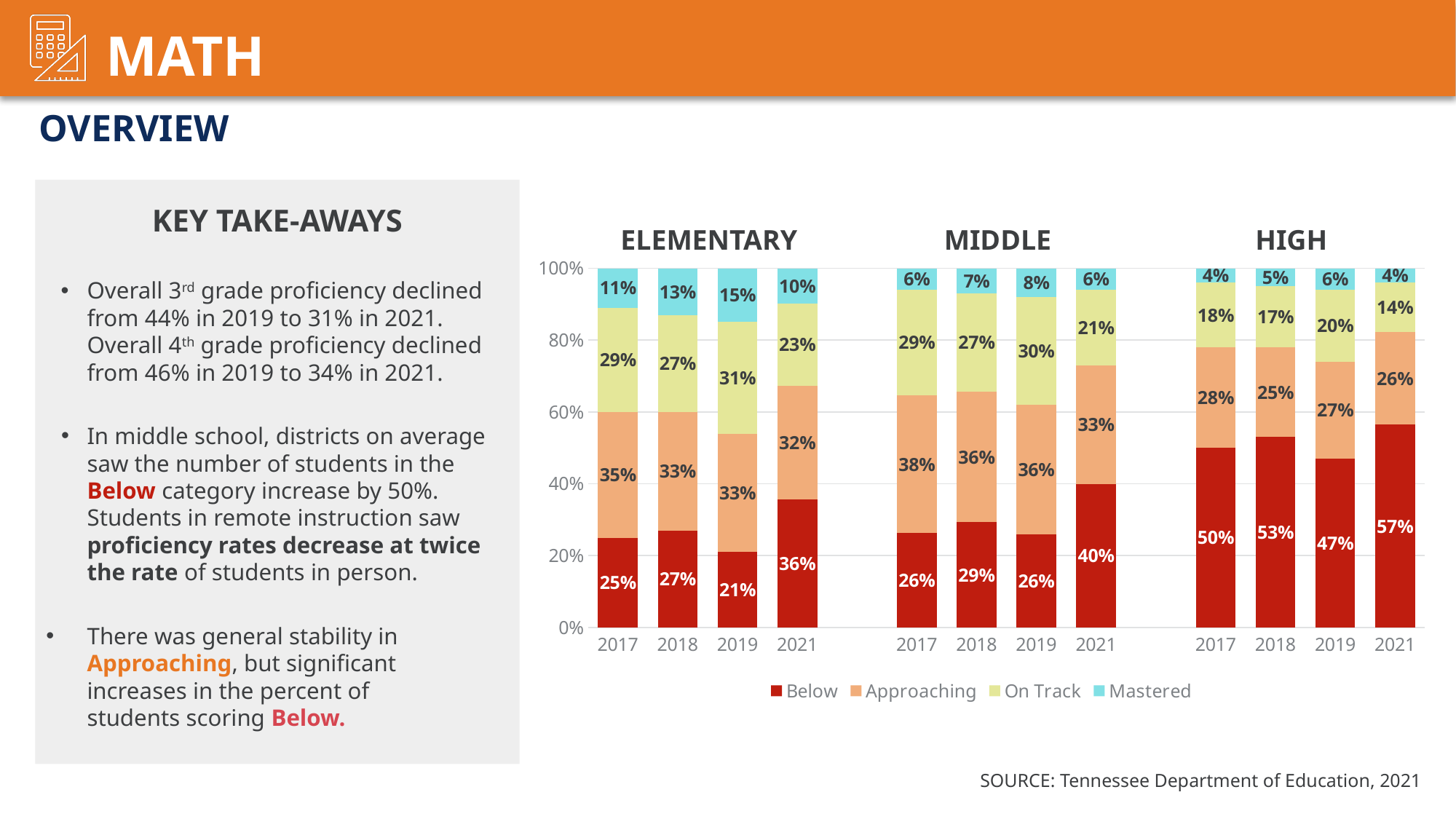
In the Elementary group, which year has the lowest Below percentage? 2019 How many series does the legend list? 4 By how many percentage points did the Elementary Below share change from 2019 to 2021? 15% Does the Mastered share for High school rise or fall from 2019 to 2021? Fall Which is larger in 2021: the Below share for Middle or the Below share for Elementary? Middle How many years are shown for each school level group? 4 In the High group, which year has the highest Below percentage? 2021 What is the combined share of Below and Approaching for High school in 2021? 83% What percentage of Middle school students were Mastered in 2019? 8% What kind of chart is shown on the slide? Stacked bar chart What percentage of Elementary students scored Below in 2021? 36% What percentage of High school students were On Track in 2018? 17%